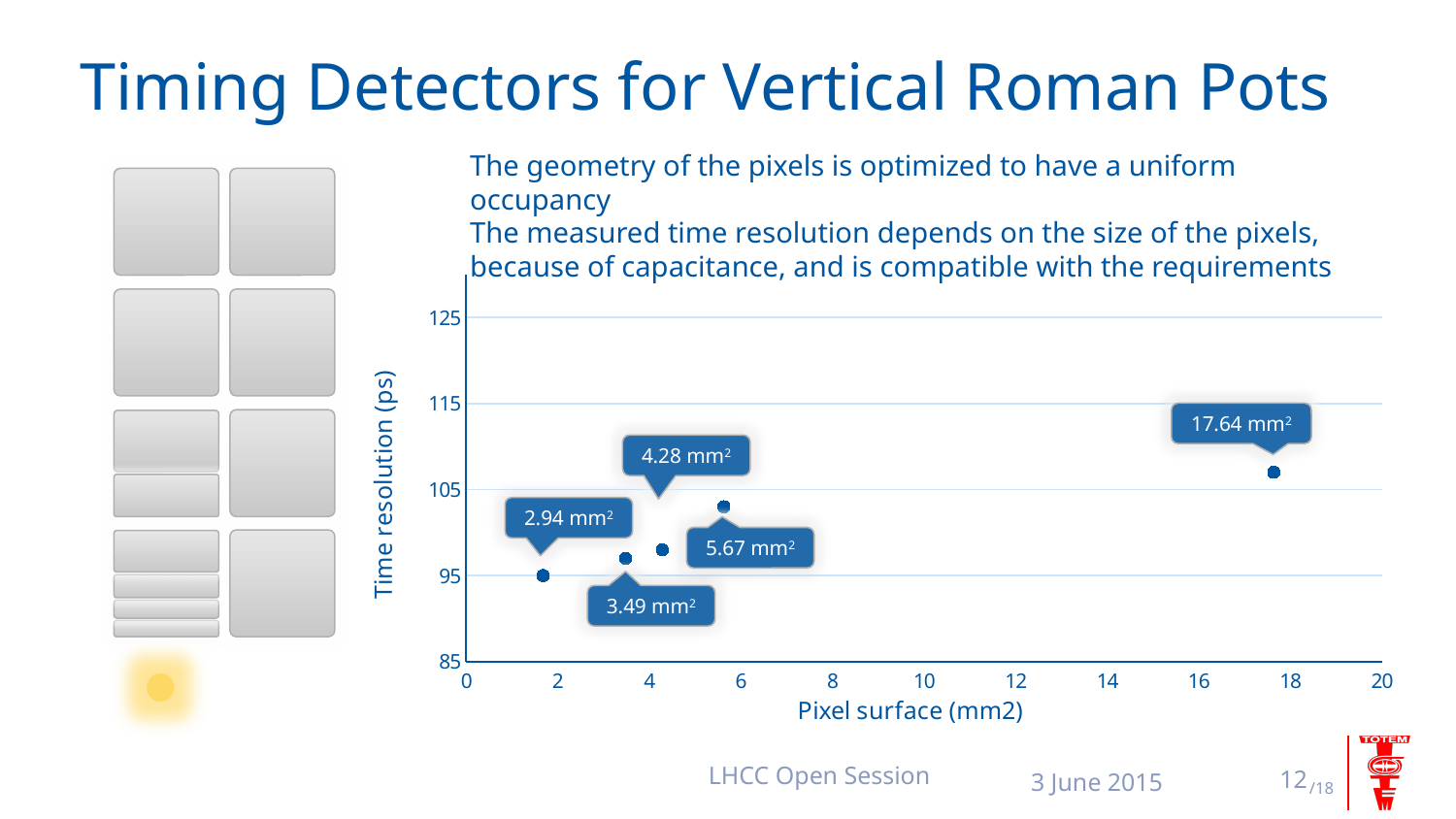
Which pixel surface has the lowest time resolution in the chart? 2.94 mm² What is the label of the x axis of the chart? Pixel surface (mm2) How many data points are plotted in the chart? 5 Is the time resolution for the 17.64 mm² pixel greater or less than 115 ps? less What kind of chart is shown on the slide? scatter chart Which has a higher time resolution, the 5.67 mm² pixel or the 3.49 mm² pixel? 5.67 mm² Does the time resolution rise or fall as the pixel surface increases? rises Which has a higher time resolution, the 17.64 mm² pixel or the 2.94 mm² pixel? 17.64 mm² Which pixel surface has the highest time resolution in the chart? 17.64 mm² Is the time resolution for the 4.28 mm² pixel greater or less than 105 ps? less Is the time resolution for the 17.64 mm² pixel greater or less than 105 ps? greater